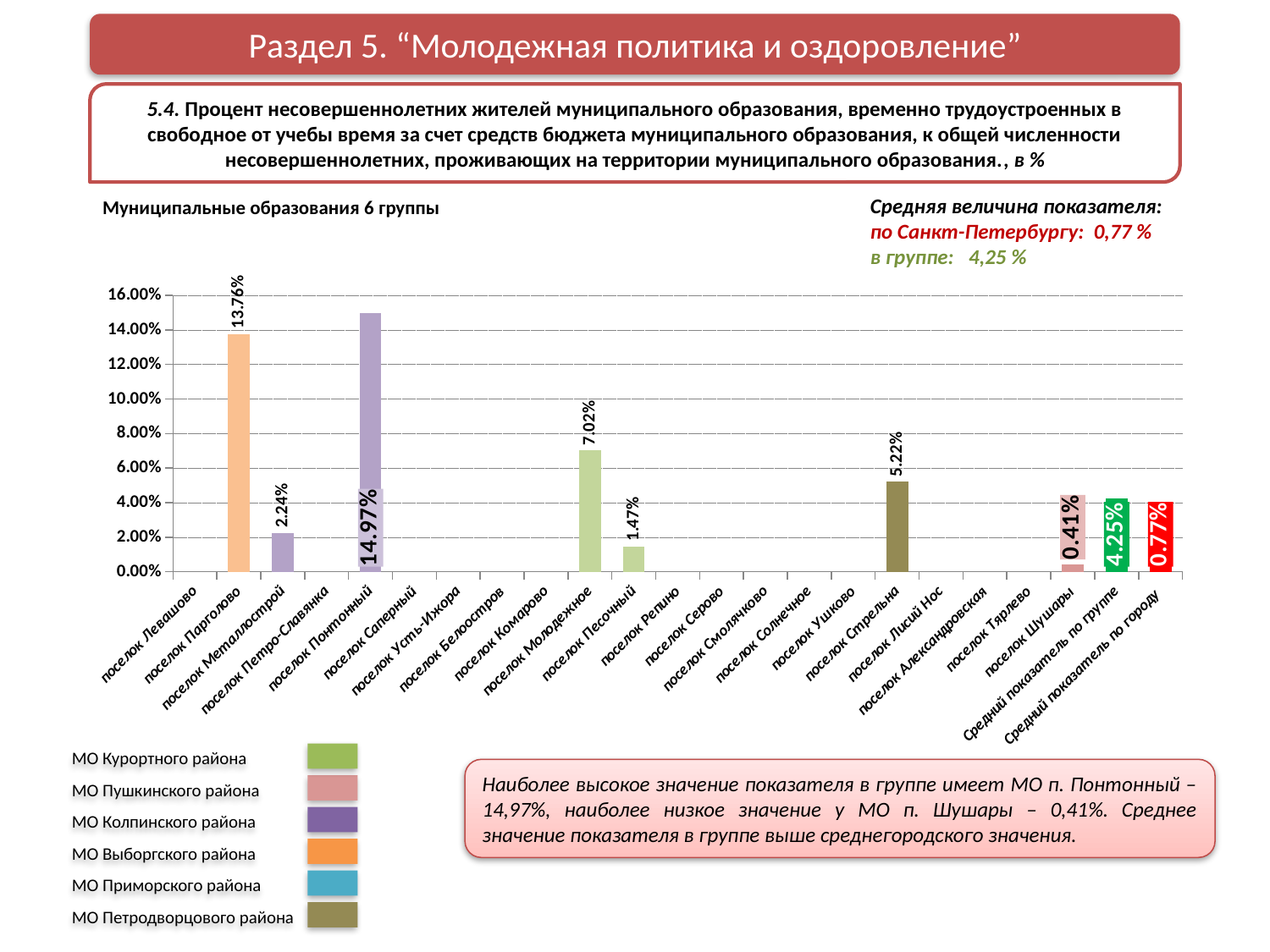
How many entries does the colour legend below the chart list? 6 What is the value for поселок Молодежное? 7.02% What kind of chart is shown on the slide? bar chart What is the difference between the values for поселок Понтонный and поселок Парголово? 1.21% Which category has the highest value on the chart? поселок Понтонный Is the value for поселок Понтонный greater or less than 14.00%? greater What is the value for поселок Понтонный? 14.97% What is the value shown for Средний показатель по городу? 0.77% Which settlement has the lowest non-zero value on the chart? поселок Шушары What is the value for поселок Парголово? 13.76% What is the value for поселок Стрельна? 5.22% Which is larger, the value for поселок Металлострой or поселок Песочный? поселок Металлострой